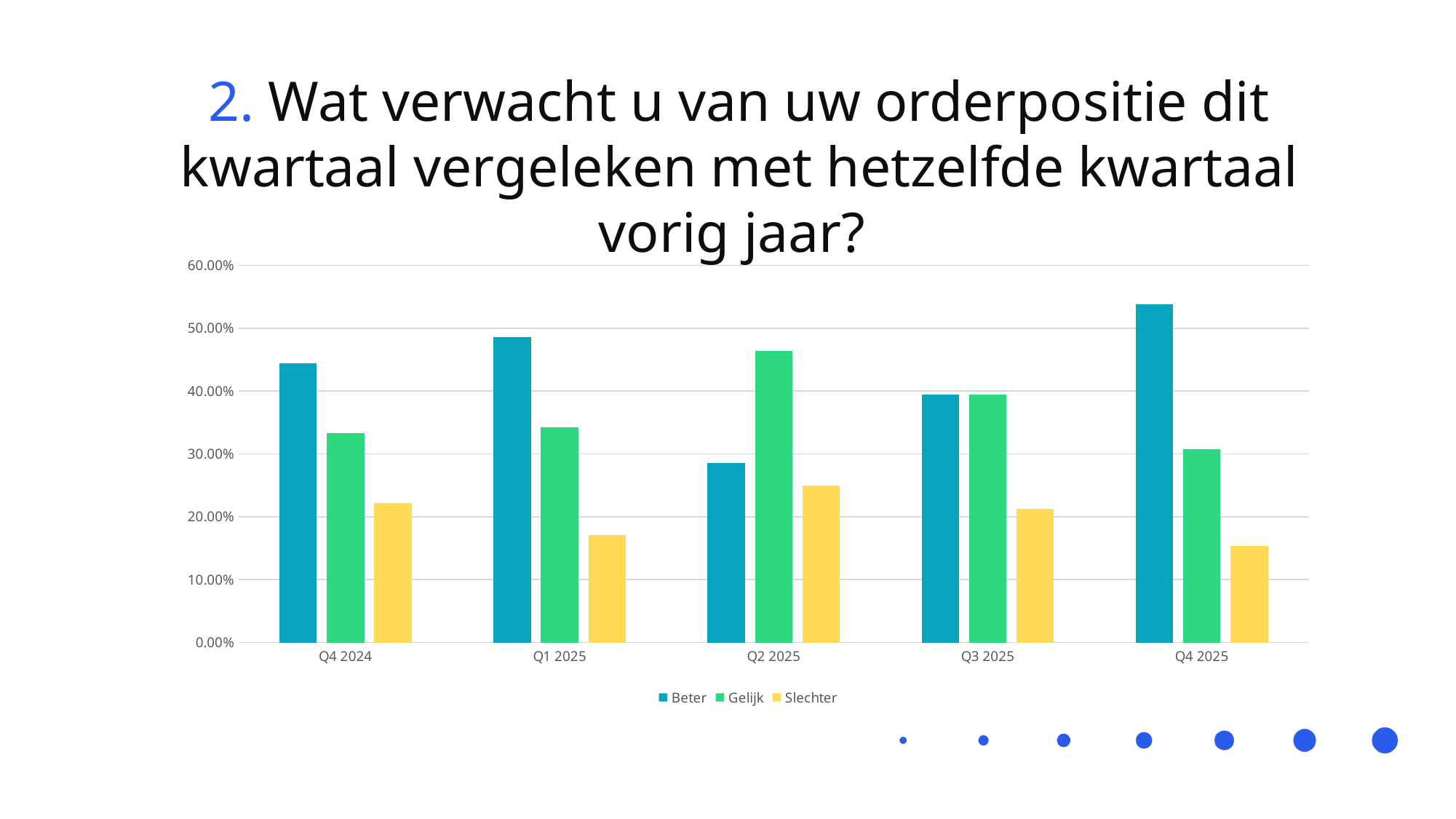
In which quarter is the value for Beter the lowest? Q2 2025 Is the value for Slechter in Q1 2025 greater or less than 20.00%? less What kind of chart is shown on the slide? bar chart In which quarter is the value for Slechter the highest? Q2 2025 Which is larger in Q2 2025, the value for Beter or the value for Gelijk? Gelijk Is the value for Beter in Q4 2025 greater or less than 50.00%? greater How many series does the legend list? 3 Which series is shown in yellow in the legend? Slechter How many quarters are shown on the x axis? 5 In which quarter is the value for Beter the highest? Q4 2025 In which quarter is the value for Gelijk the highest? Q2 2025 Is the value for Beter in Q2 2025 greater or less than 30.00%? less